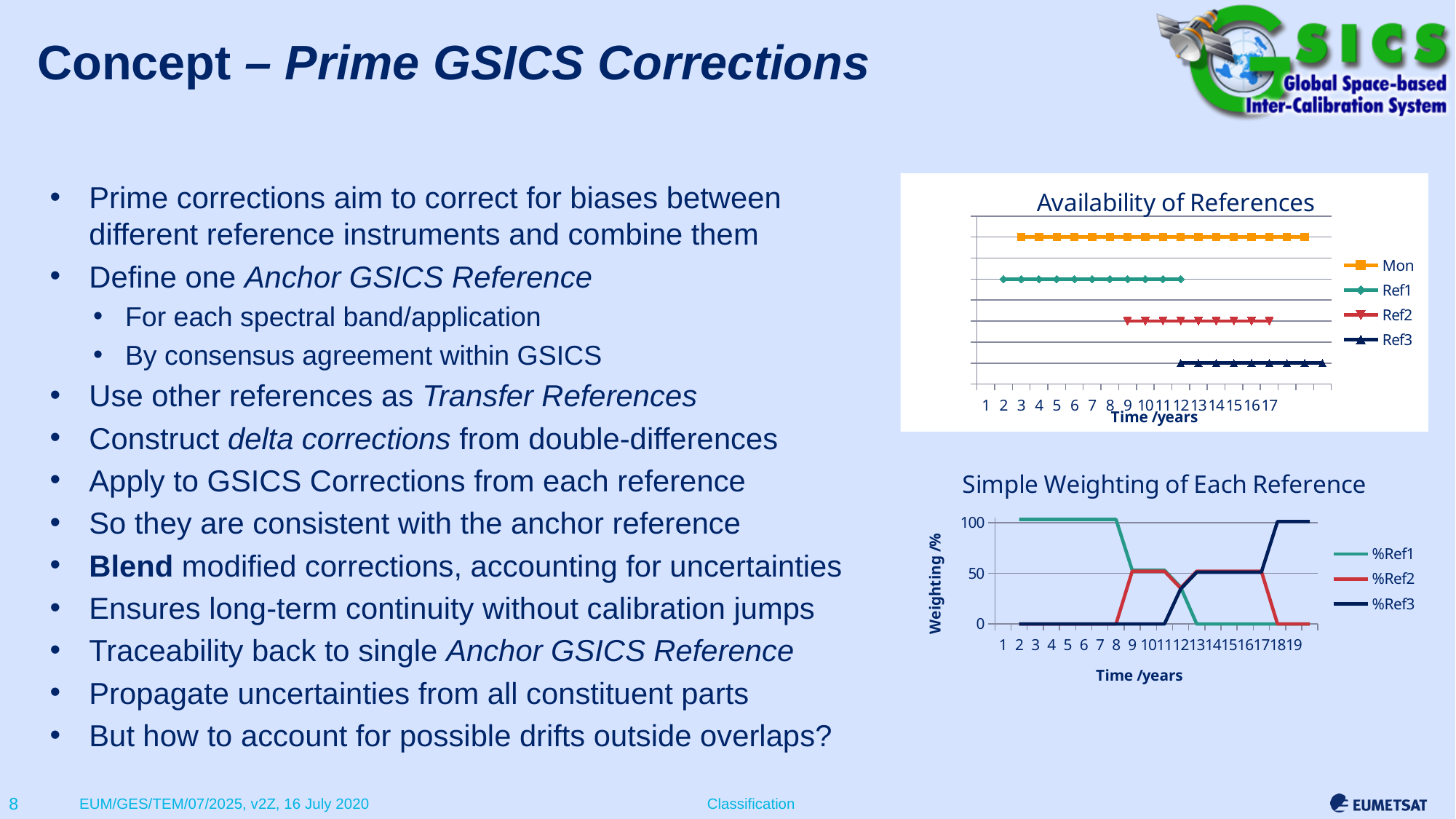
How many series does the legend of the 'Simple Weighting of Each Reference' chart list? 3 What is the x-axis label of the 'Availability of References' chart? Time /years How many series does the legend of the 'Availability of References' chart list? 4 In the 'Simple Weighting of Each Reference' chart, what is the value of %Ref1 at year 15? 0 In the 'Simple Weighting of Each Reference' chart, which is larger at year 5: %Ref1 or %Ref3? %Ref1 In the 'Simple Weighting of Each Reference' chart, does %Ref1 rise or fall along the x axis overall? Fall What kind of chart is the 'Availability of References' chart? Line chart What kind of chart is the 'Simple Weighting of Each Reference' chart? Line chart In the 'Availability of References' chart, which series is shown with orange square markers? Mon